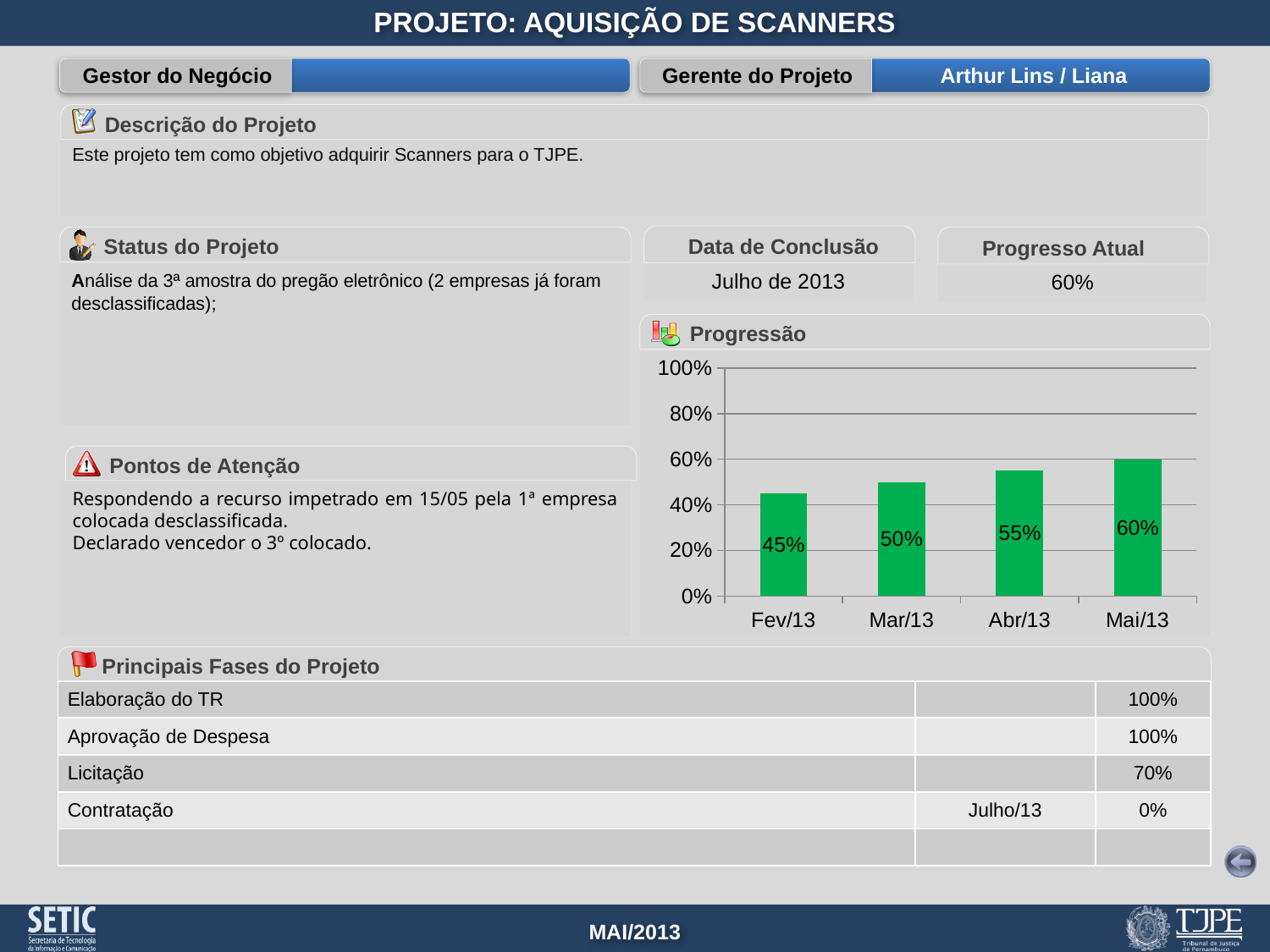
Which is larger in the Progressão chart, the value for Mar/13 or the value for Abr/13? Abr/13 How many months are shown on the x axis of the Progressão chart? 4 What is the value for Fev/13 in the Progressão chart? 45% What is the value for Mar/13 in the Progressão chart? 50% Is the value for Abr/13 in the Progressão chart greater or less than 40%? greater What kind of chart is the Progressão chart? bar chart What is the value for Mai/13 in the Progressão chart? 60% What is the value for Abr/13 in the Progressão chart? 55% Which month has the highest value in the Progressão chart? Mai/13 Which month has the lowest value in the Progressão chart? Fev/13 Do the values in the Progressão chart rise or fall from Fev/13 to Mai/13? rise What is the difference between the values for Mai/13 and Fev/13 in the Progressão chart? 15%